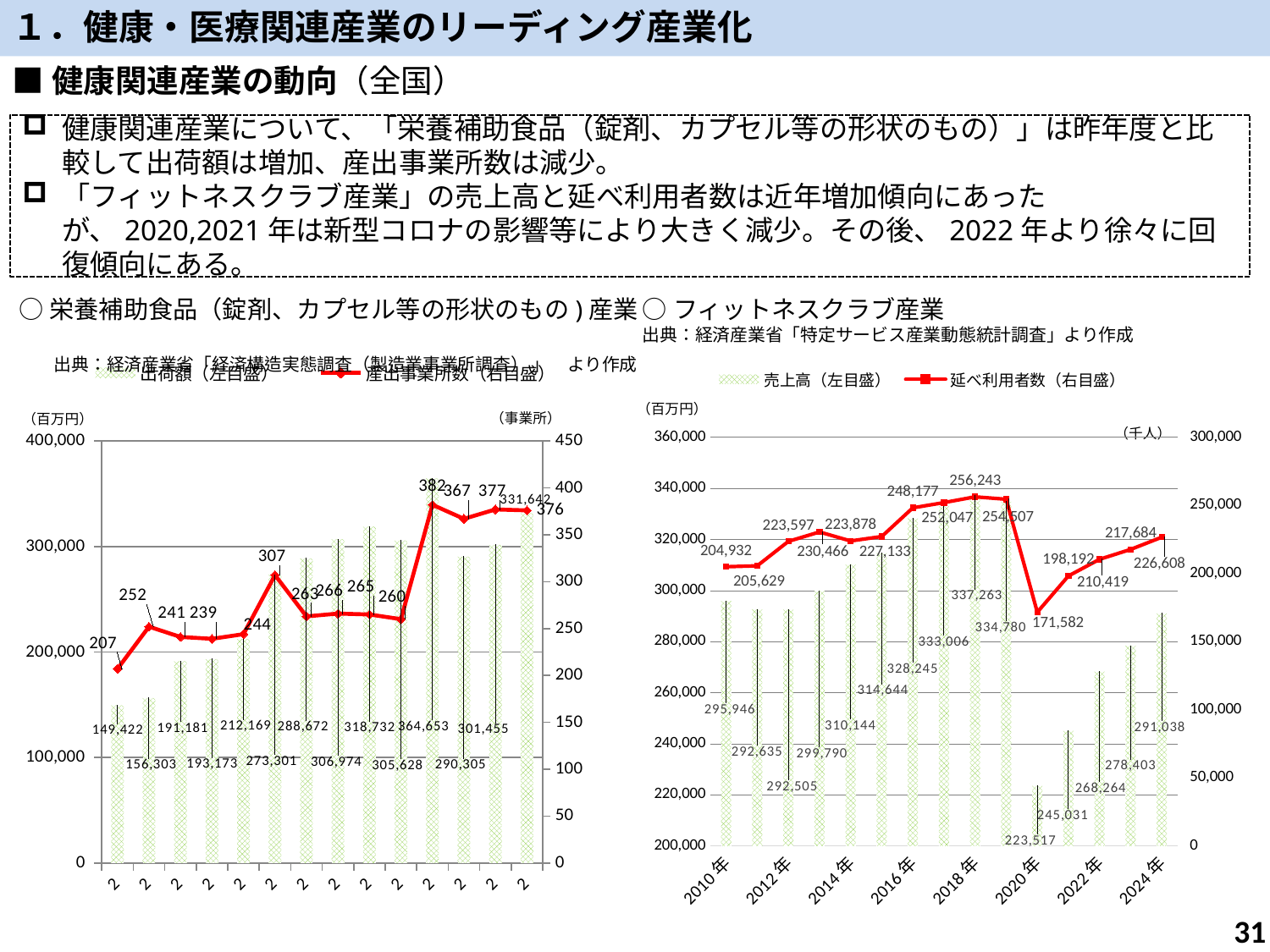
In the 栄養補助食品 chart on the left, how many series does the legend list? 2 In the フィットネスクラブ産業 chart on the right, what is the difference between the 売上高 for 2018年 and 2020年? 113,746 In the 栄養補助食品 chart on the left, how many bars are plotted? 14 In the 栄養補助食品 chart on the left, what is the highest 産出事業所数 value shown on the line? 382 In the フィットネスクラブ産業 chart on the right, what is the 延べ利用者数 value for 2018年? 256,243 In the 栄養補助食品 chart on the left, what is the lowest 出荷額 value shown on the bars? 149,422 In the フィットネスクラブ産業 chart on the right, does the 延べ利用者数 line rise or fall from 2020年 to 2024年? rise In the フィットネスクラブ産業 chart on the right, which year has the lowest 売上高? 2020年 In the フィットネスクラブ産業 chart on the right, which year has the larger 売上高, 2010年 or 2024年? 2010年 In the フィットネスクラブ産業 chart on the right, what is the 売上高 value for 2020年? 223,517 In the フィットネスクラブ産業 chart on the right, which year has the highest 売上高? 2018年 In the フィットネスクラブ産業 chart on the right, how many bars are plotted? 15